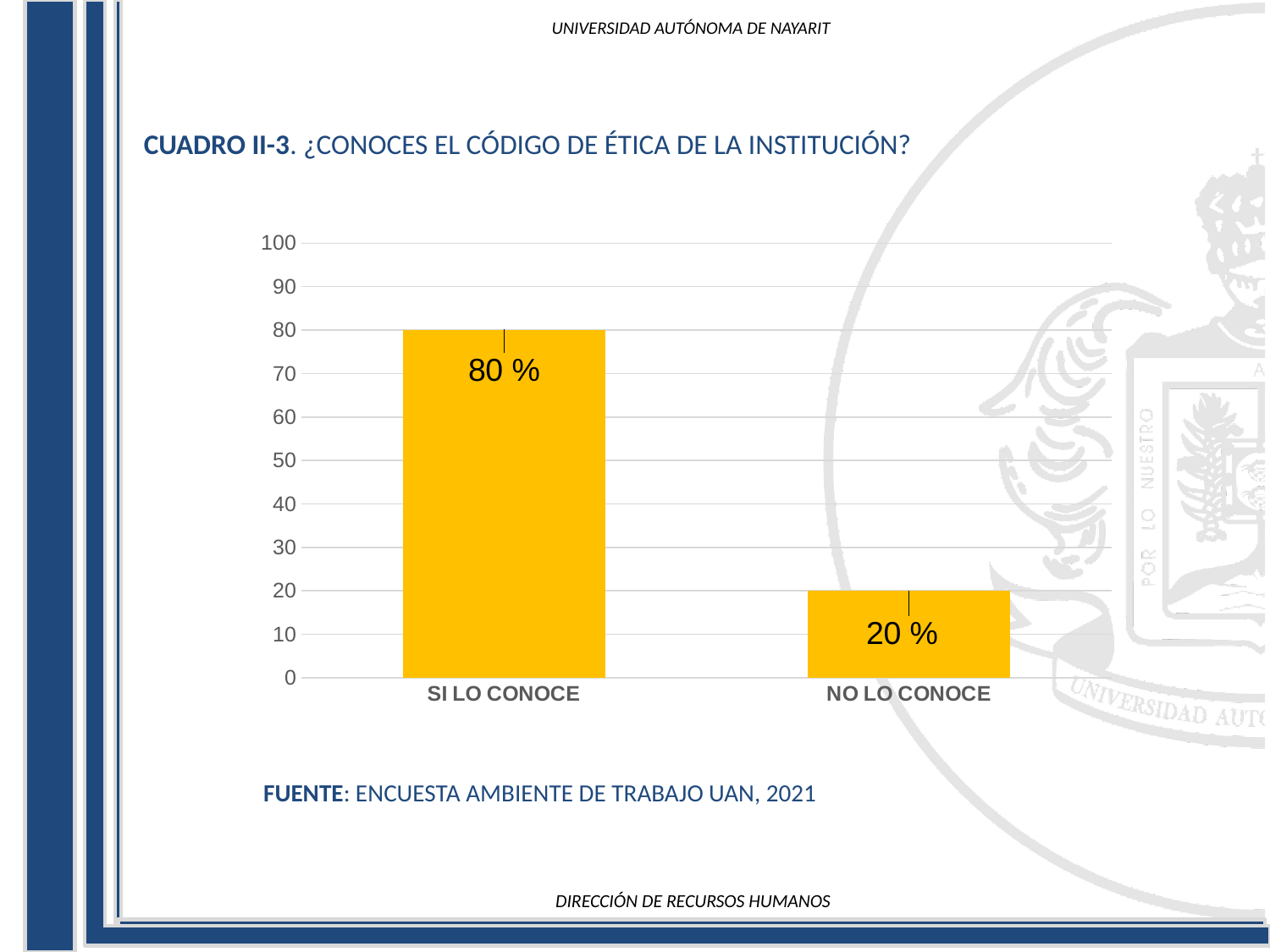
Which category has the highest value? SI LO CONOCE Which is larger, the value for SI LO CONOCE or NO LO CONOCE? SI LO CONOCE Is the value for SI LO CONOCE greater or less than 50? greater What kind of chart is shown on the slide? bar chart What is the difference between the values for SI LO CONOCE and NO LO CONOCE? 60 % How many categories are shown on the x axis? 2 Which category has the lowest value? NO LO CONOCE Is the value for NO LO CONOCE greater or less than 30? less What colour are the bars in the chart? yellow What is the maximum value shown on the y axis? 100 What is the value for SI LO CONOCE? 80 % What is the value for NO LO CONOCE? 20 %